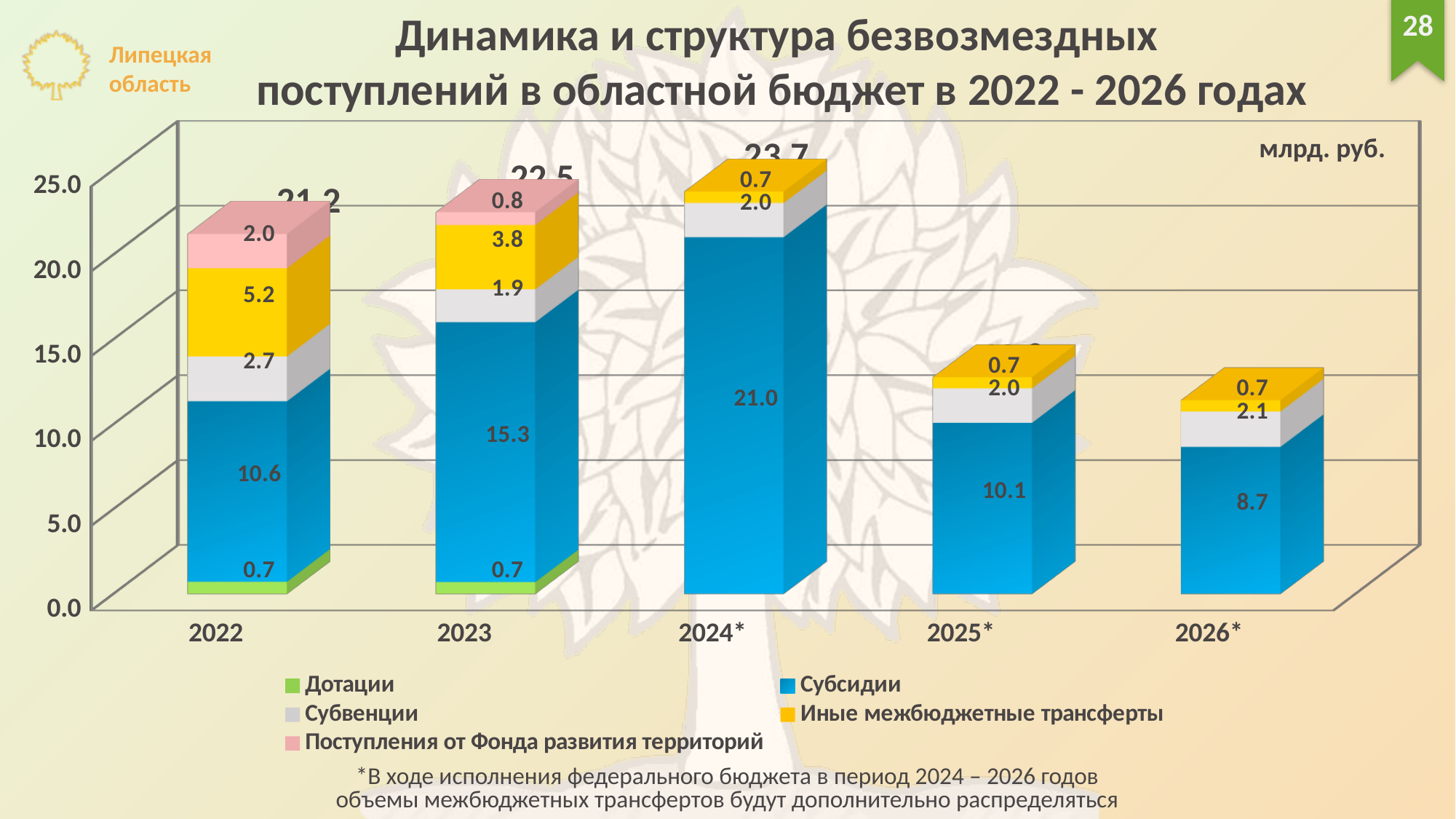
What is the total shown above the bar for 2024*? 23.7 Is the total bar for 2025* greater or less than 15.0? less Which year has the highest total of безвозмездные поступления? 2024* Which year has the lowest total bar? 2026* How many series does the legend list? 5 Which is larger: Субсидии in 2025* or Субсидии in 2026*? 2025* What is the value of Субсидии for 2022? 10.6 What is the value of Субвенции for 2026*? 2.1 What is the difference between the Субсидии values for 2024* and 2023? 5.7 Do the Субсидии values rise or fall from 2024* to 2026*? fall What is the value of Иные межбюджетные трансферты for 2023? 3.8 What is the total of the stacked bar for 2026*? 11.5